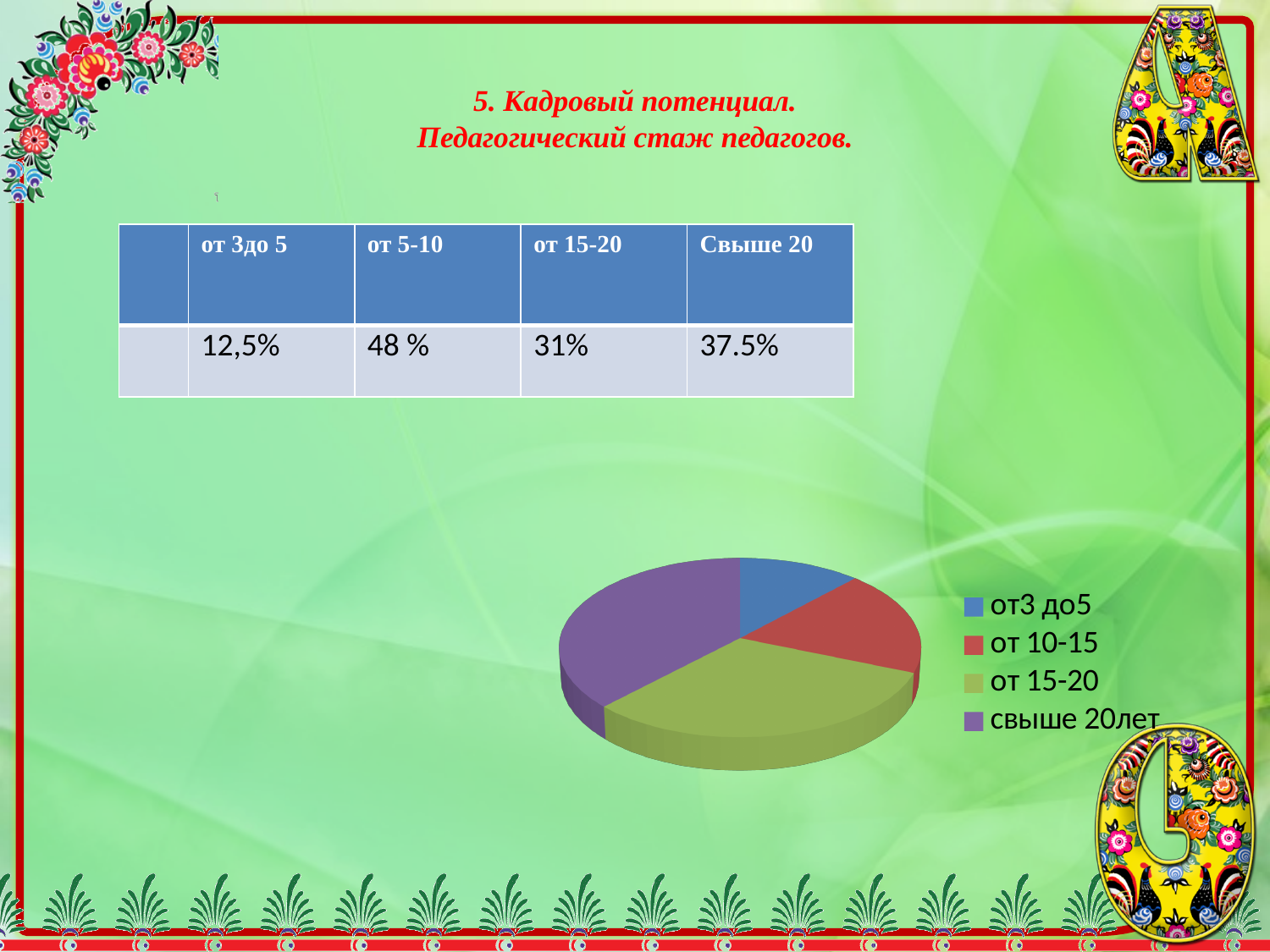
Which colour represents свыше 20лет in the pie chart? purple How many slices does the pie chart have? 4 Which category has the smallest slice in the pie chart? от3 до5 What kind of chart is shown on the slide? pie chart In the pie chart, which slice is larger: свыше 20лет or от 10-15? свыше 20лет How many entries does the pie chart's legend list? 4 Which legend entry is shown in blue in the pie chart? от3 до5 In the pie chart, which slice is larger: от 15-20 or от3 до5? от 15-20 In the pie chart, which slice is larger: от3 до5 or от 10-15? от 10-15